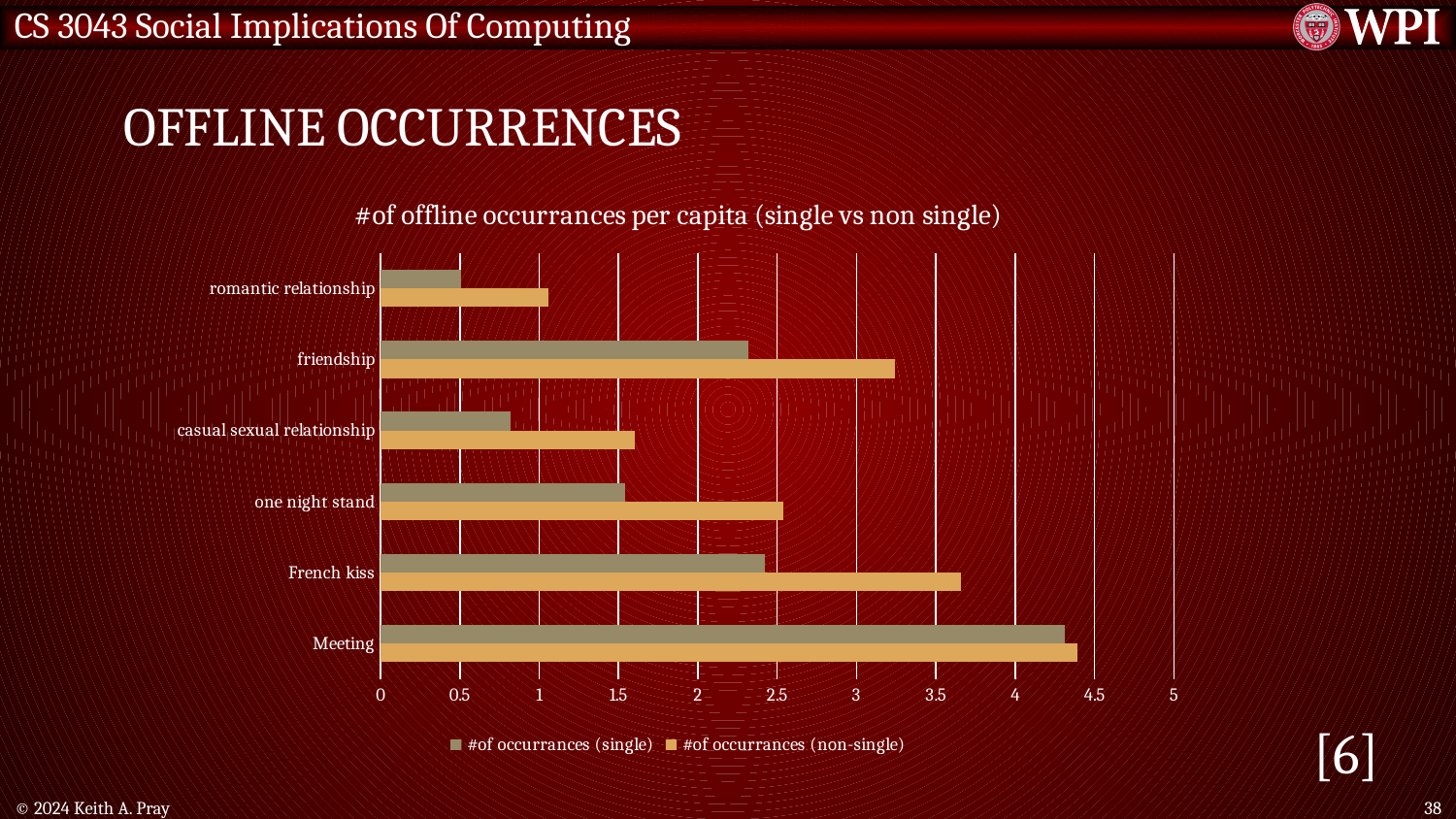
How many series does the legend list? 2 Is the value for romantic relationship in the #of occurrances (single) series greater or less than 1? less Which category has the lowest value for #of occurrances (single)? romantic relationship What kind of chart is shown on the slide? bar chart Which category has the highest value for #of occurrances (non-single)? Meeting How many categories are shown on the chart? 6 Which is larger for #of occurrances (non-single): friendship or one night stand? friendship Is the value for Meeting in the #of occurrances (single) series greater or less than 4? greater What is the title of the chart? #of offline occurrances per capita (single vs non single) Is the value for French kiss in the #of occurrances (non-single) series greater or less than 3.5? greater Which legend entry is shown in orange? #of occurrances (non-single)